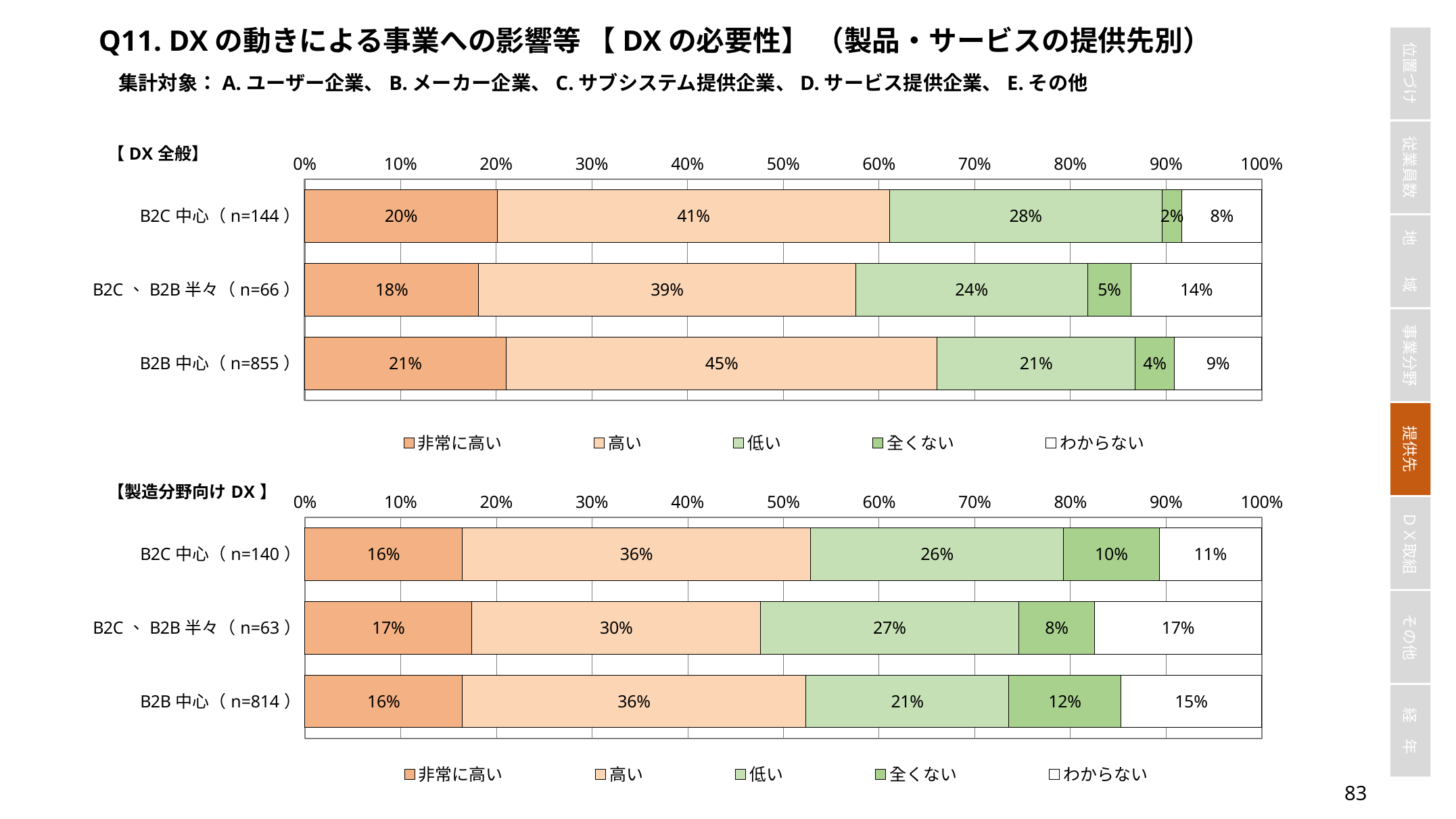
How many series does the legend of the 【DX全般】 chart list? 5 In the 【製造分野向けDX】 chart, what is the value of 全くない for B2B中心（n=814）? 12% In the 【製造分野向けDX】 chart, which is larger: わからない for B2C、B2B半々（n=63） or わからない for B2C中心（n=140）? B2C、B2B半々（n=63） In the 【DX全般】 chart, what is the difference between the 低い values for B2C中心（n=144） and B2B中心（n=855）? 7% What kind of chart is the 【DX全般】 chart? Stacked bar chart In the 【DX全般】 chart, what is the value of わからない for B2C、B2B半々（n=66）? 14% In the 【製造分野向けDX】 chart, which category has the lowest value for 高い? B2C、B2B半々（n=63） In the 【DX全般】 chart, which category has the highest value for 非常に高い? B2B中心（n=855） How many categories are shown in the 【製造分野向けDX】 chart? 3 In the 【製造分野向けDX】 chart, what is the value of 低い for B2C中心（n=140）? 26% In the 【DX全般】 chart, what is the value of 高い for B2B中心（n=855）? 45% In the 【DX全般】 chart, what is the combined value of 非常に高い and 高い for B2C中心（n=144）? 61%